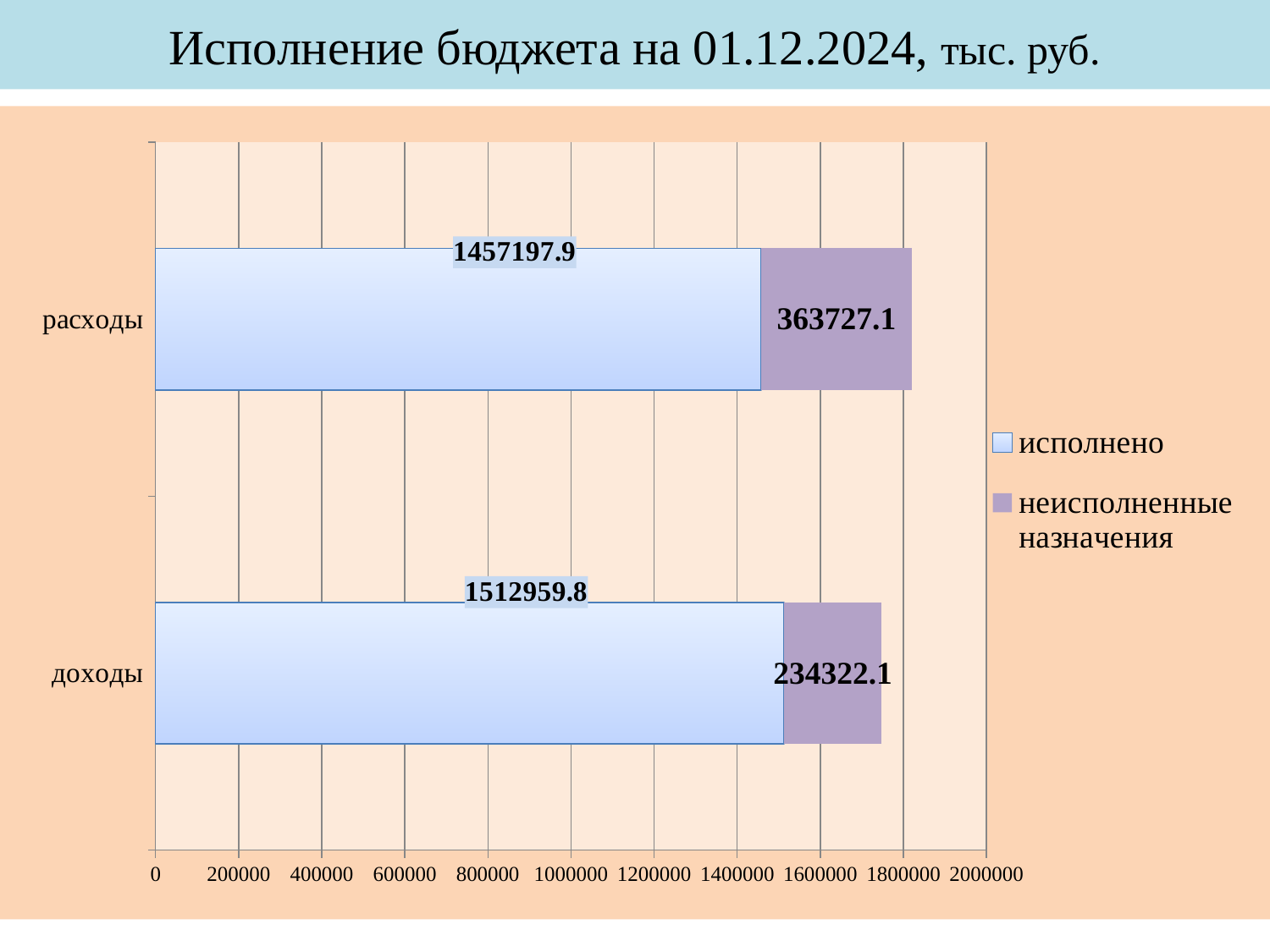
What is the total of the stacked bar for расходы? 1820925.0 What is the value of неисполненные назначения for доходы? 234322.1 What is the total of the stacked bar for доходы? 1747281.9 Which category has the lowest value for неисполненные назначения? доходы How many series does the legend list? 2 What is the title of the chart? Исполнение бюджета на 01.12.2024, тыс. руб. What type of chart is shown on the slide? bar chart Which category has the higher value for исполнено? доходы How many categories are shown on the chart? 2 What is the value of исполнено for расходы? 1457197.9 What is the difference between the неисполненные назначения values for расходы and доходы? 129405.0 What is the value of неисполненные назначения for расходы? 363727.1